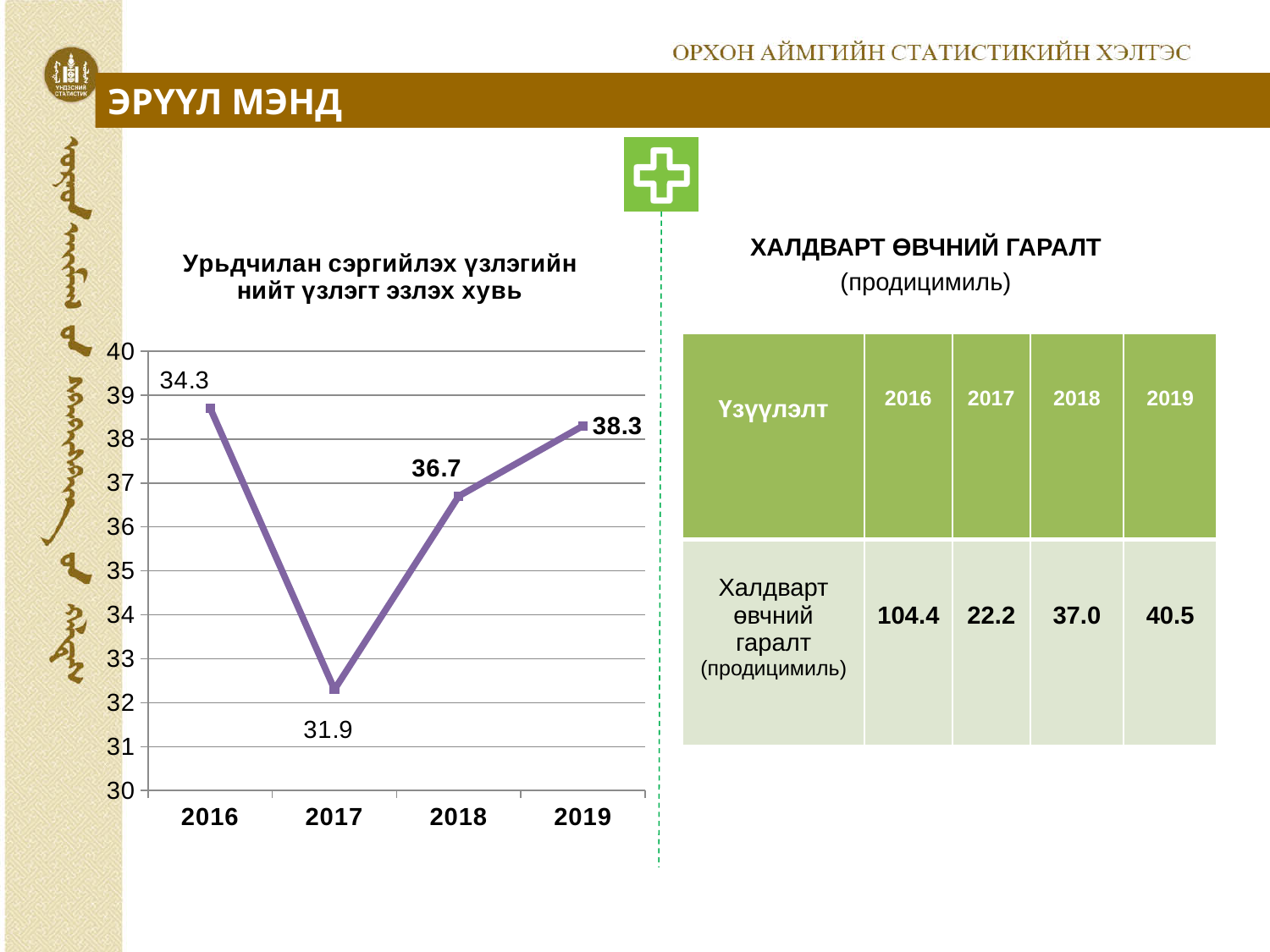
What is the value for 2017 in the line chart? 31.9 Does the value in the line chart rise or fall from 2017 to 2019? rise What is the value for 2018 in the line chart? 36.7 What is the value for 2019 in the line chart? 38.3 What is the difference between the 2019 and 2017 values in the line chart? 6.4 What is the value for 2016 in the line chart? 34.3 What is the difference between the 2016 and 2017 values in the line chart? 2.4 Which year has the lowest value in the line chart? 2017 What kind of chart is shown on the slide? line chart How many years are plotted in the line chart? 4